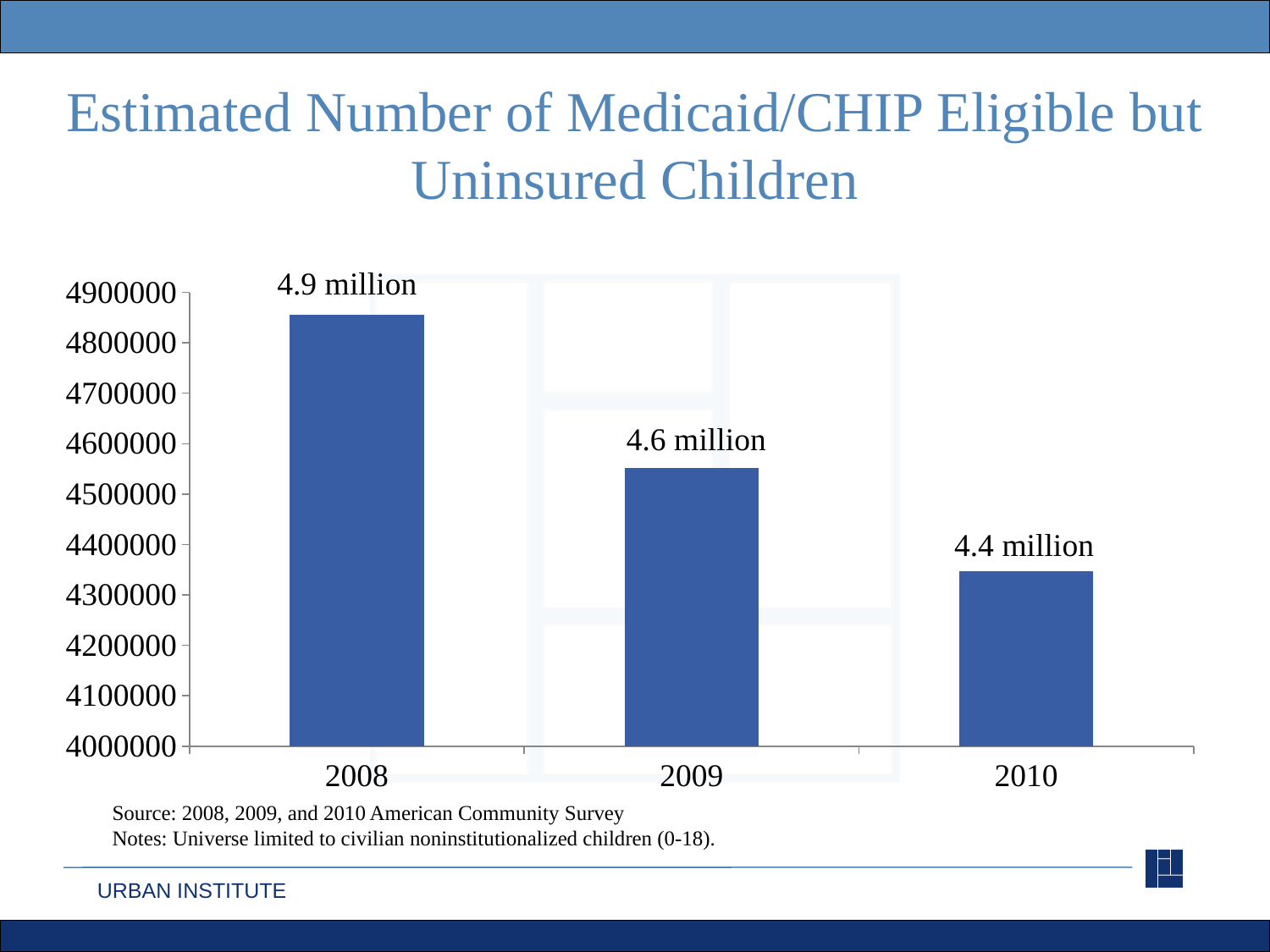
How many years are shown on the chart? 3 Which is larger, the value for 2008 or the value for 2010? 2008 What is the estimated number of Medicaid/CHIP eligible but uninsured children in 2009? 4.6 million Is the value for 2010 greater or less than 4400000? less Which year has the lowest estimated number of eligible but uninsured children? 2010 What kind of chart is shown on the slide? Bar chart Do the values rise or fall from 2008 to 2010? Fall Is the value for 2009 greater or less than 4500000? greater Is the value for 2008 greater or less than 4800000? greater Which year has the highest estimated number of eligible but uninsured children? 2008 What is the estimated number of Medicaid/CHIP eligible but uninsured children in 2010? 4.4 million What is the estimated number of Medicaid/CHIP eligible but uninsured children in 2008? 4.9 million